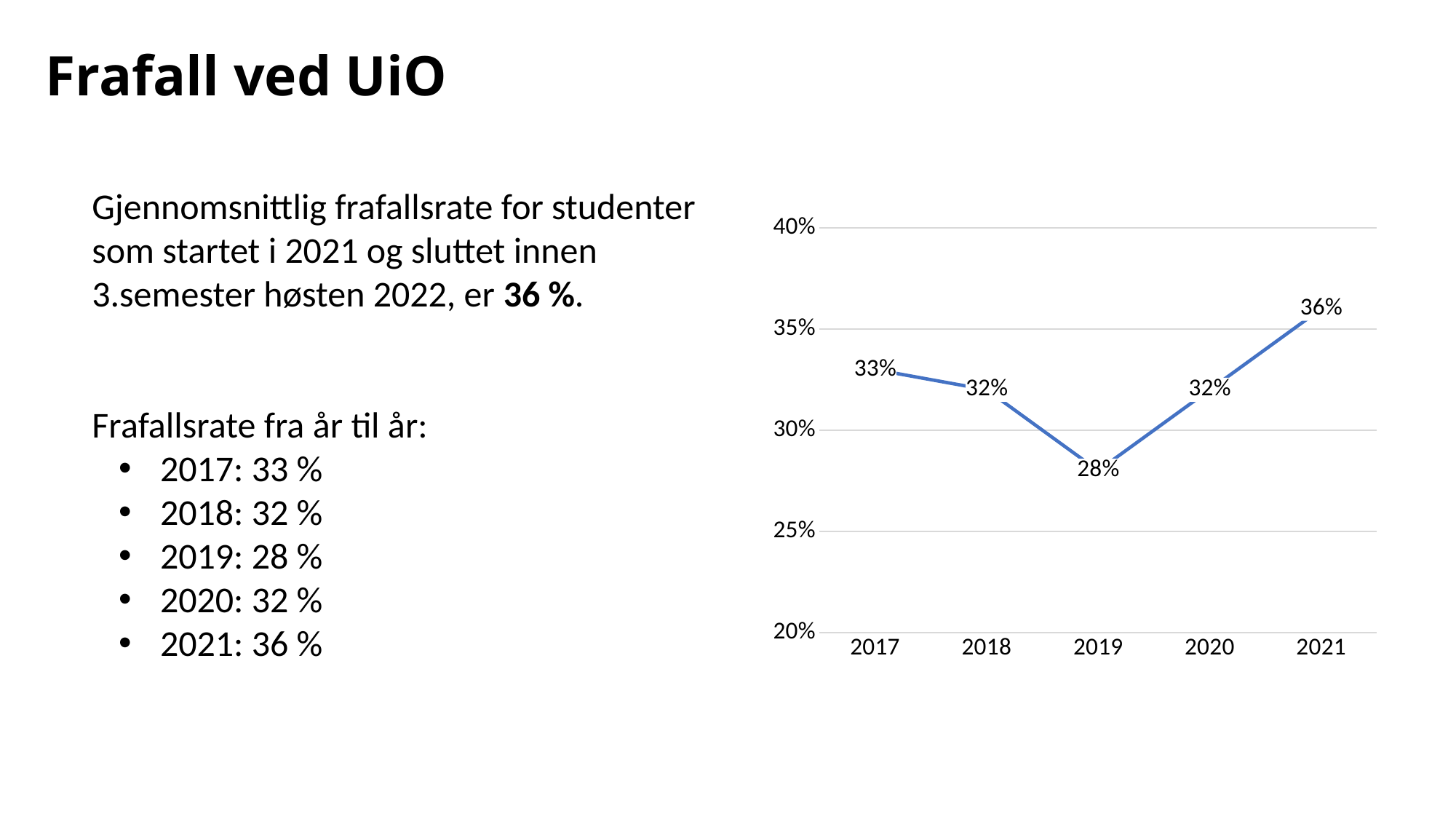
Which year has the highest value in the chart? 2021 Which is larger, the value for 2017 or the value for 2019? 2017 What is the value for 2017 in the chart? 33% How many years are plotted in the chart? 5 What is the difference between the values for 2021 and 2019? 8% Which year has the lowest value in the chart? 2019 What is the value for 2019 in the chart? 28% What is the value for 2021 in the chart? 36% What is the difference between the values for 2017 and 2018? 1% Does the value rise or fall from 2019 to 2021? rise What kind of chart is shown on the slide? line chart Is the value for 2021 greater or less than 35%? greater